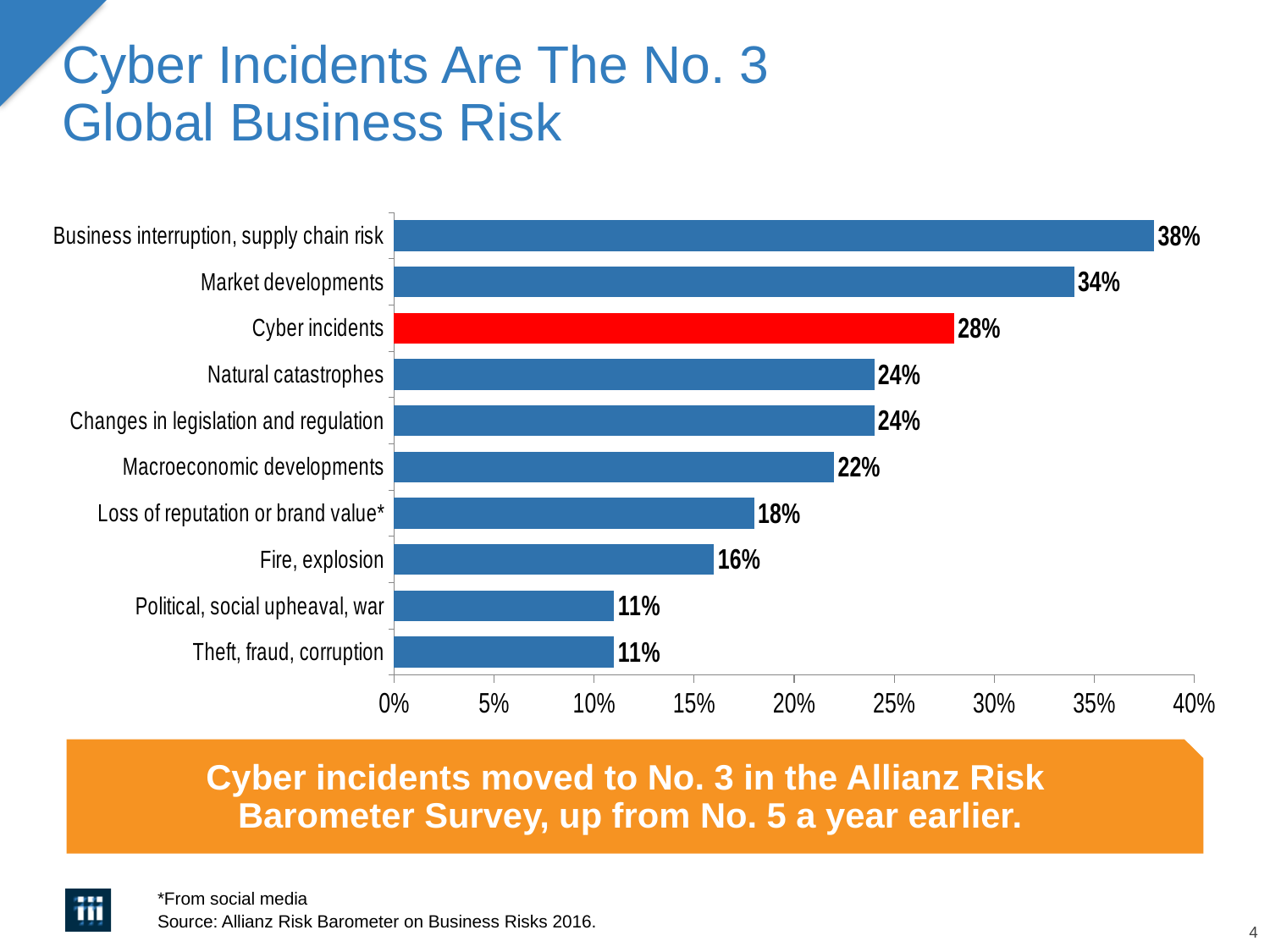
What is the value for Market developments? 34% What is the value for Fire, explosion? 16% Which is larger, Natural catastrophes or Fire, explosion? Natural catastrophes What is the difference between Macroeconomic developments and Loss of reputation or brand value*? 4% How many categories are shown in the chart? 10 Which category has the highest value? Business interruption, supply chain risk What is the maximum value shown on the x axis? 40% Which bar is coloured red? Cyber incidents Which is larger, Market developments or Macroeconomic developments? Market developments What is the value for Cyber incidents? 28% What is the difference between Business interruption, supply chain risk and Cyber incidents? 10% What kind of chart is shown on the slide? Bar chart